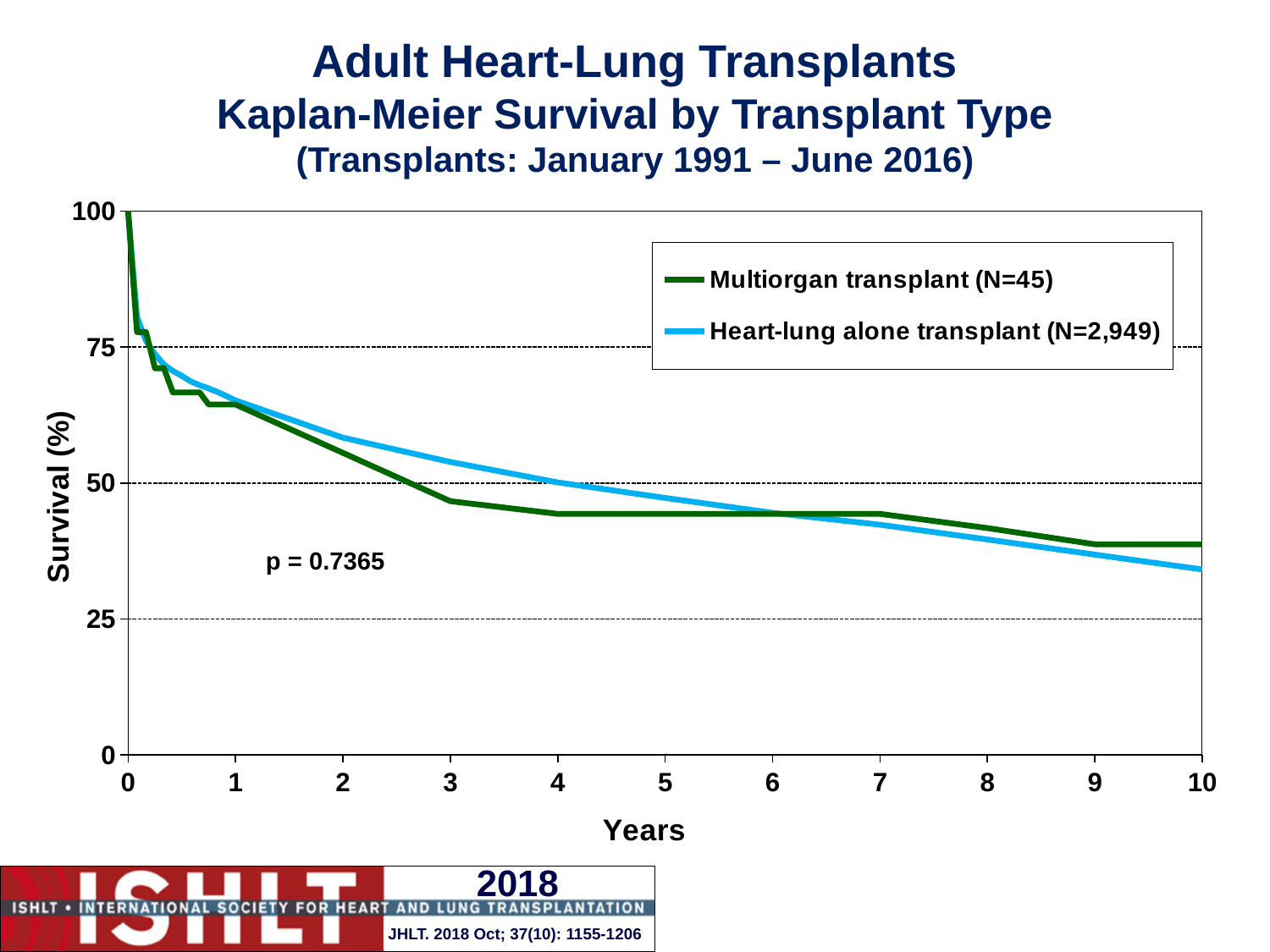
What kind of chart is shown on the slide? line chart Is the survival value for Heart-lung alone transplant at year 1 greater or less than 75? less Is the survival value for Multiorgan transplant at year 4 greater or less than 50? less Is the survival value for Heart-lung alone transplant at year 2 greater or less than 50? greater Do the survival curves rise or fall as years increase? fall How many series does the legend list? 2 At year 3, which series has the higher survival: Multiorgan transplant or Heart-lung alone transplant? Heart-lung alone transplant What is the p-value printed on the chart? p = 0.7365 What is the label of the y axis? Survival (%) What is the N for the Heart-lung alone transplant series in the legend? 2,949